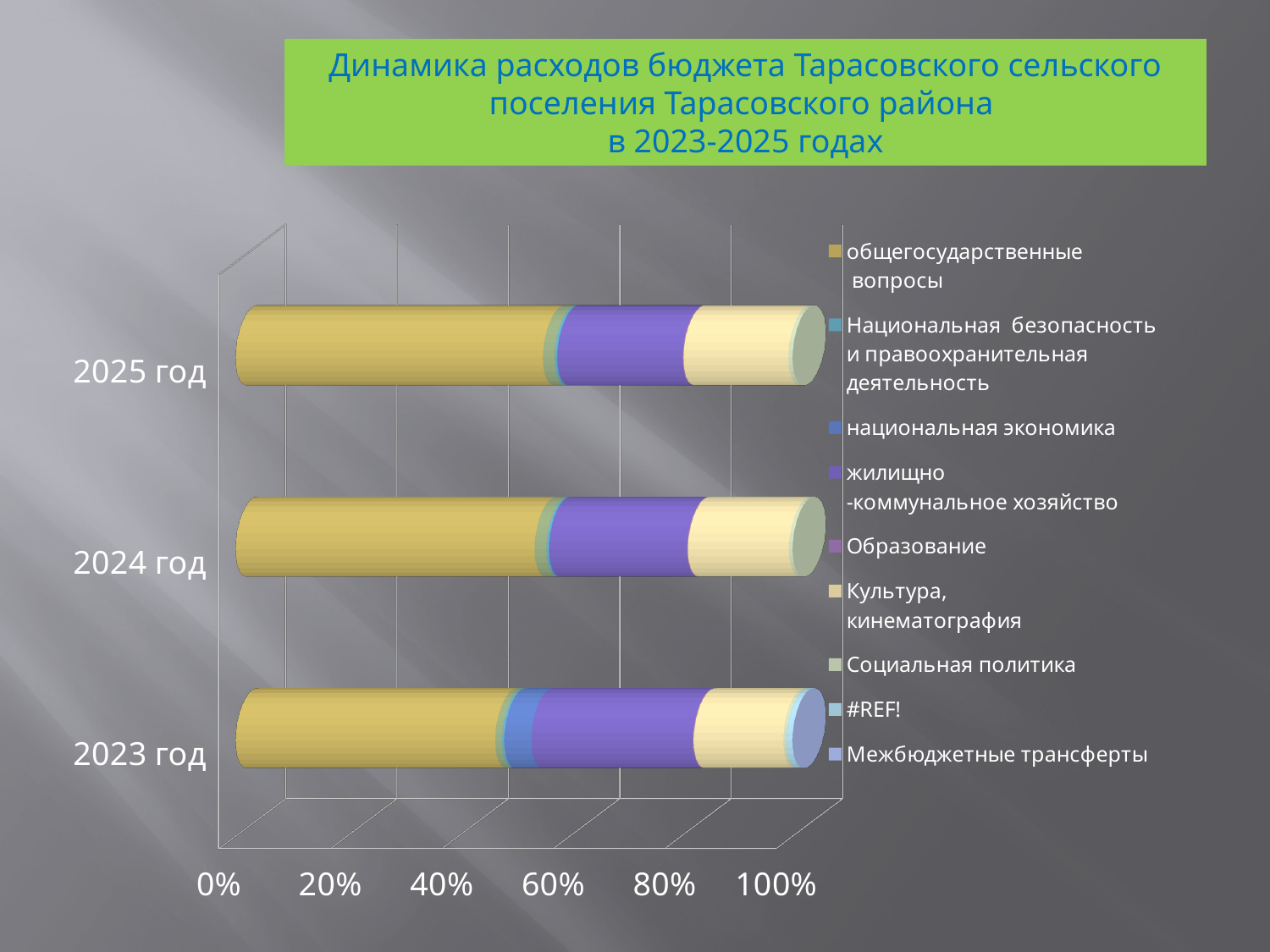
Is the share of общегосударственные вопросы in 2023 год greater or less than 40%? greater Is the share of общегосударственные вопросы in 2025 год greater or less than 40%? greater Which year has the larger share of общегосударственные вопросы, 2023 год or 2025 год? 2025 год What is the title of the chart on the slide? Динамика расходов бюджета Тарасовского сельского поселения Тарасовского района в 2023-2025 годах How many series does the legend list? 9 Is the share of общегосударственные вопросы in 2023 год greater or less than 60%? less Which year shows the largest share of национальная экономика? 2023 год How many years (categories) are plotted on the chart? 3 What kind of chart is shown on the slide? bar chart Which legend entry appears as an error text rather than a category name? #REF! What is the highest value shown on the horizontal axis? 100%